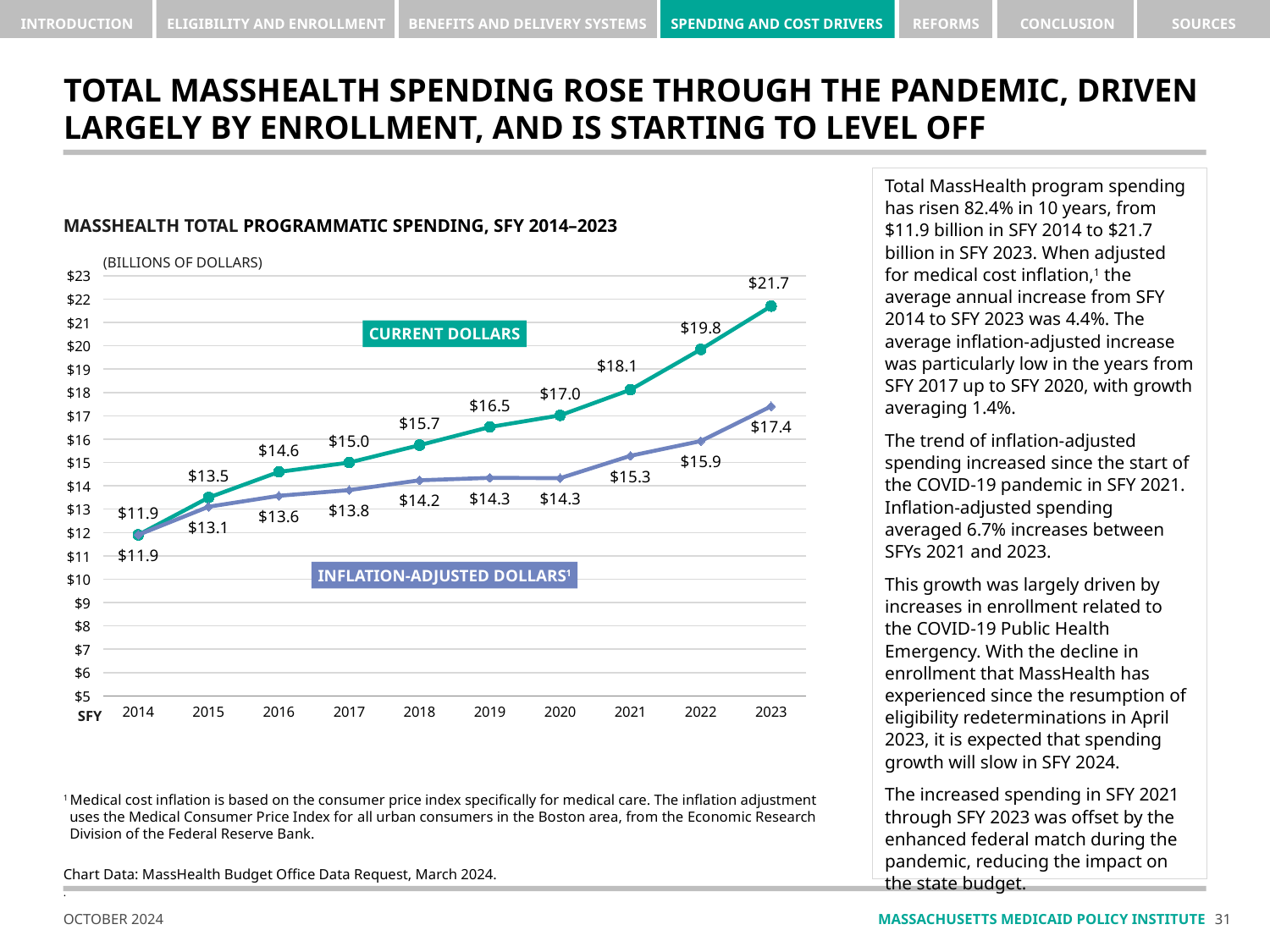
Which year has the highest current-dollar spending? 2023 What is the difference between current-dollar and inflation-adjusted spending in SFY 2023? $4.3 How many data series does the chart show? 2 Which is larger in SFY 2021: current-dollar spending or inflation-adjusted spending? Current dollars What is the unit shown for the y axis of the chart? Billions of dollars How many fiscal years are plotted on the x axis? 10 What was the inflation-adjusted spending value for SFY 2020? $14.3 Which year has the lowest inflation-adjusted spending? 2014 What type of chart is shown on the slide? Line chart What was spending in current dollars in SFY 2018? $15.7 What was MassHealth total programmatic spending in current dollars in SFY 2023? $21.7 By how much did current-dollar spending increase from SFY 2014 to SFY 2023? $9.8